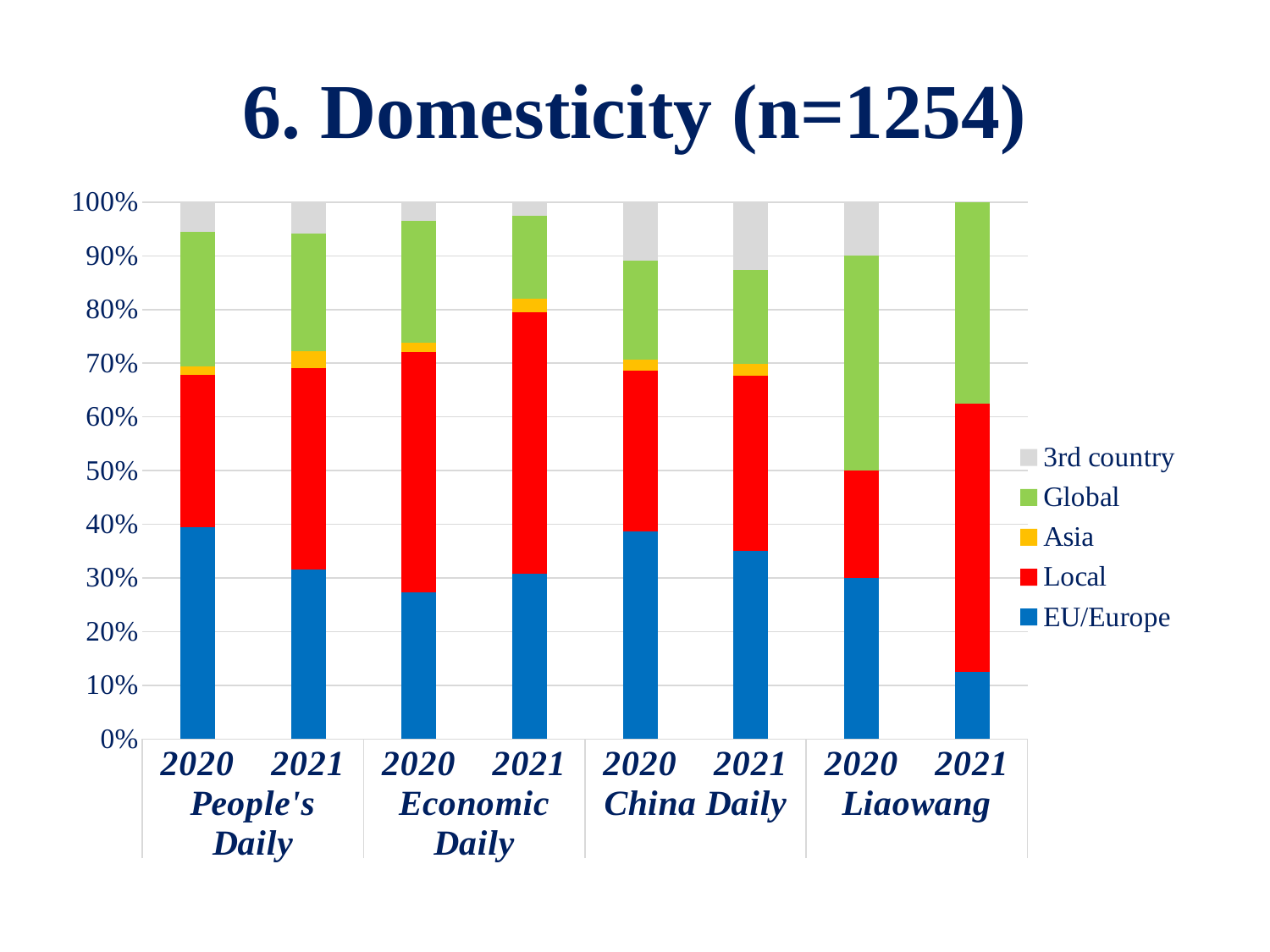
Is the EU/Europe value for Liaowang 2021 greater or less than 20%? less Which is larger, the EU/Europe share for China Daily 2020 or for Liaowang 2020? China Daily 2020 How many bars are plotted in the chart? 8 Is the EU/Europe value for People's Daily 2020 greater or less than 30%? greater Is the EU/Europe value for Economic Daily 2020 greater or less than 30%? less How many series does the legend list? 5 Which is larger, the EU/Europe share for People's Daily in 2020 or in 2021? 2020 What kind of chart is shown on the slide? Stacked bar chart What is the title of the chart slide? 6. Domesticity (n=1254) Which bar has the smallest EU/Europe share? Liaowang 2021 How many publications are shown on the x axis? 4 Which colour represents the Local series in the legend? Red